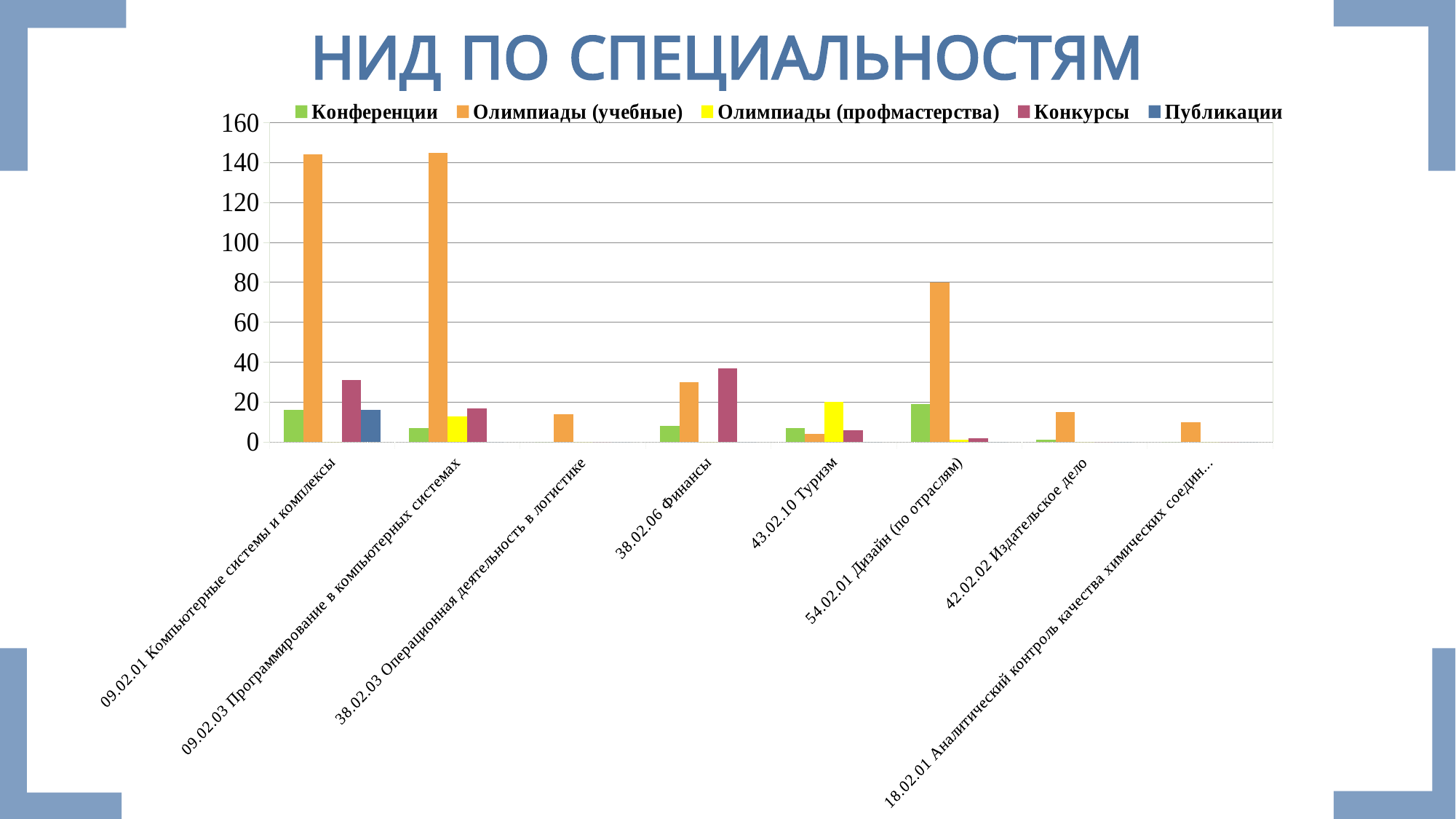
Which category has the highest value for Конкурсы? 38.02.06 Финансы What kind of chart is shown on the slide? bar chart Which category has the lowest non-zero value for Олимпиады (учебные)? 43.02.10 Туризм Which is the only category with a bar for Публикации? 09.02.01 Компьютерные системы и комплексы Is the value of Олимпиады (учебные) for 38.02.03 Операционная деятельность в логистике greater or less than 20? less For 38.02.06 Финансы, which is larger: Конкурсы or Олимпиады (учебные)? Конкурсы Is the value of Олимпиады (учебные) for 09.02.01 Компьютерные системы и комплексы greater or less than 120? greater Is the value of Конкурсы for 38.02.06 Финансы greater or less than 40? less What is the title of the chart? НИД ПО СПЕЦИАЛЬНОСТЯМ How many specialities (categories) are shown on the x axis? 8 How many series does the legend list? 5